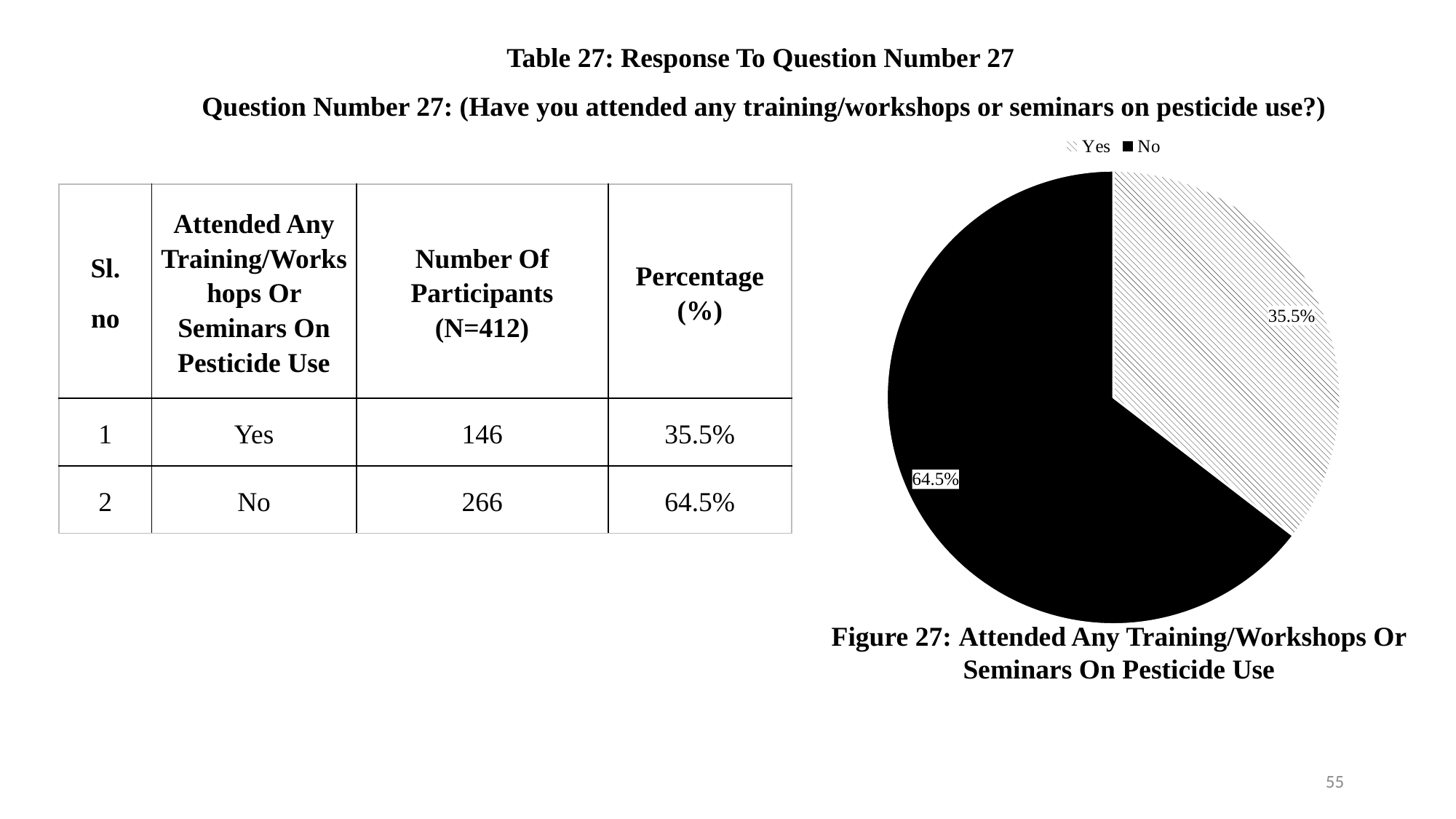
Which slice of the pie chart is the smallest? Yes How many slices does the pie chart have? 2 Which slice of the pie chart is filled in solid black? No Which slice of the pie chart is the largest? No Which is larger in the pie chart, the 'Yes' slice or the 'No' slice? No What is the difference in percentage points between the 'No' slice and the 'Yes' slice in the pie chart? 29 percentage points What is the title of the figure containing the pie chart? Figure 27: Attended Any Training/Workshops Or Seminars On Pesticide Use What percentage does the 'Yes' slice of the pie chart show? 35.5% What percentage does the 'No' slice of the pie chart show? 64.5% What kind of chart is shown in Figure 27? pie chart How many entries does the legend of the pie chart list? 2 What share of the pie does the 'Yes' slice represent? 35.5%